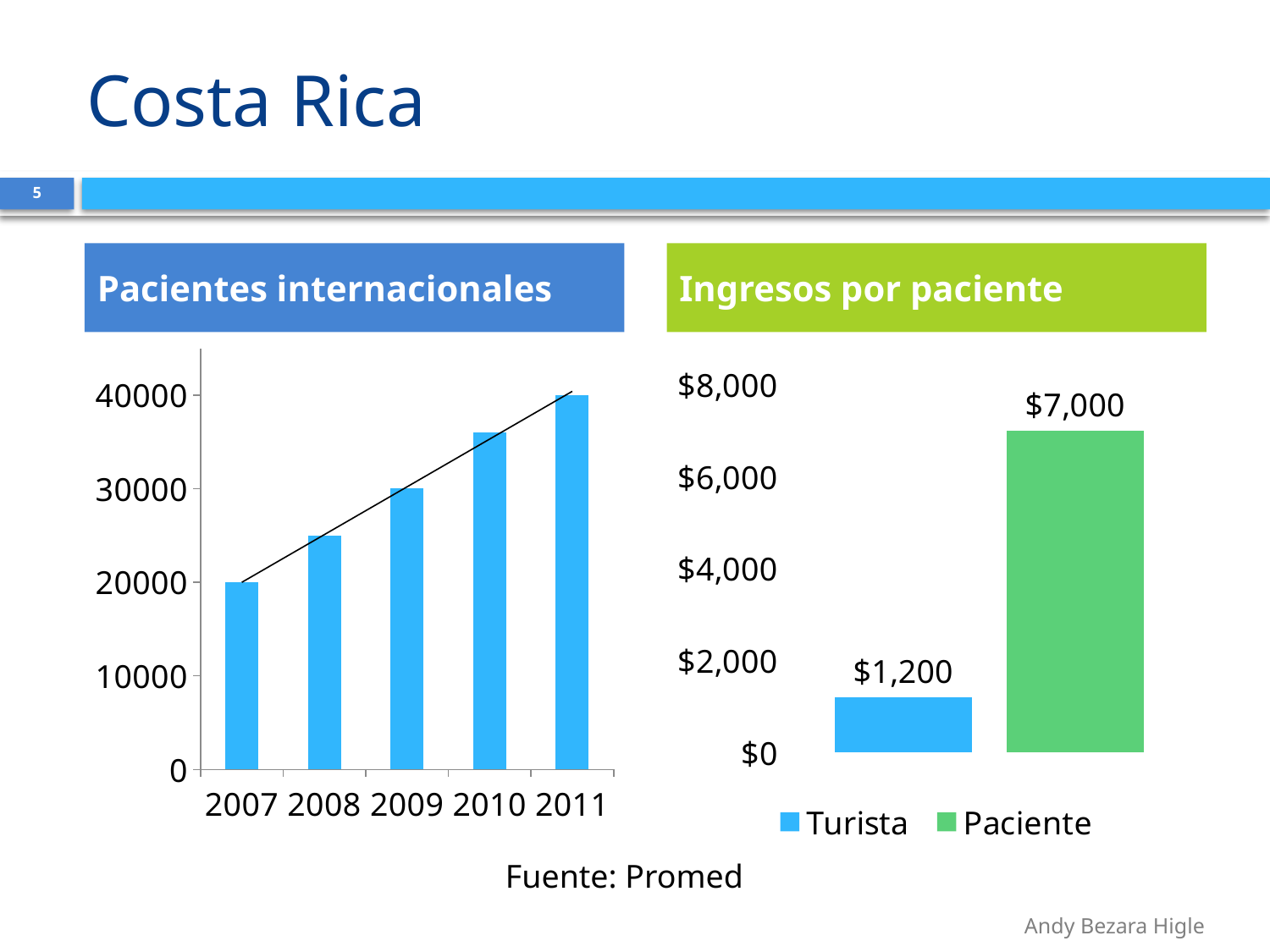
In the 'Ingresos por paciente' chart, which is larger, Turista or Paciente? Paciente In the 'Pacientes internacionales' chart, is the value for 2010 greater or less than 30000? greater In the 'Ingresos por paciente' chart, what is the value for Turista? $1,200 In the 'Ingresos por paciente' chart, what colour is the Paciente bar? Green In the 'Pacientes internacionales' chart, which year has the highest value? 2011 In the 'Ingresos por paciente' chart, how many entries does the legend list? 2 What kind of chart is the 'Pacientes internacionales' chart? Bar chart In the 'Pacientes internacionales' chart, how many years are shown on the x axis? 5 In the 'Ingresos por paciente' chart, what is the difference between Paciente and Turista? $5,800 In the 'Pacientes internacionales' chart, which year has the lowest value? 2007 In the 'Ingresos por paciente' chart, what is the value for Paciente? $7,000 In the 'Pacientes internacionales' chart, do the values rise or fall from 2007 to 2011? Rise